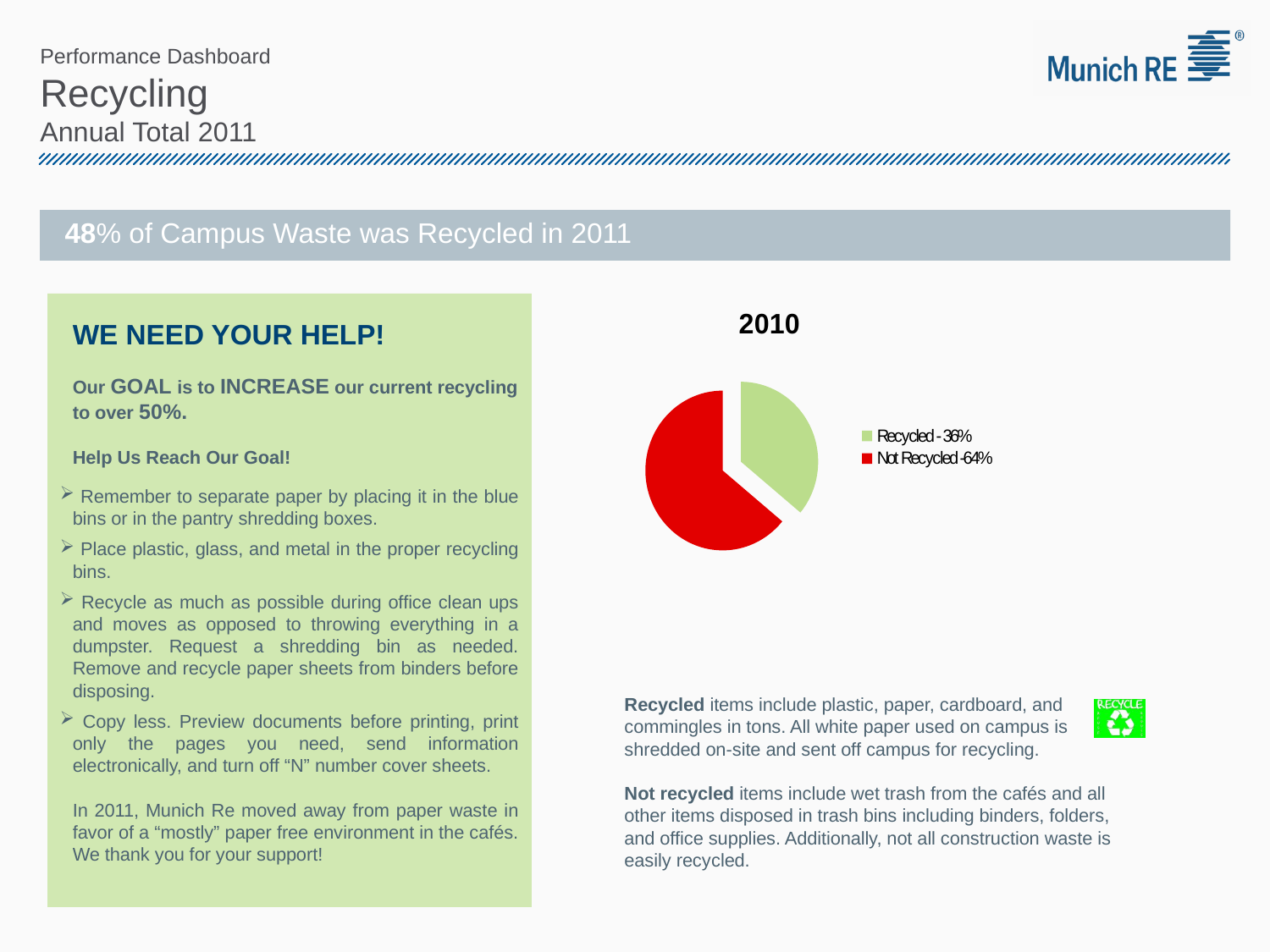
What is the title of the pie chart? 2010 What kind of chart is shown on the slide? pie chart How many slices does the pie chart have? 2 What share of the pie does Not Recycled represent? 64% What share of the pie does Recycled represent? 36% What colour is the Not Recycled slice in the pie chart? red What is the difference in percentage points between Not Recycled and Recycled in the pie chart? 28 Which slice of the pie chart is the largest? Not Recycled How many entries does the legend of the pie chart list? 2 Which slice of the pie chart is the smallest? Recycled Is the Recycled share in the pie chart greater or less than 50%? less Which is larger in the pie chart, Recycled or Not Recycled? Not Recycled